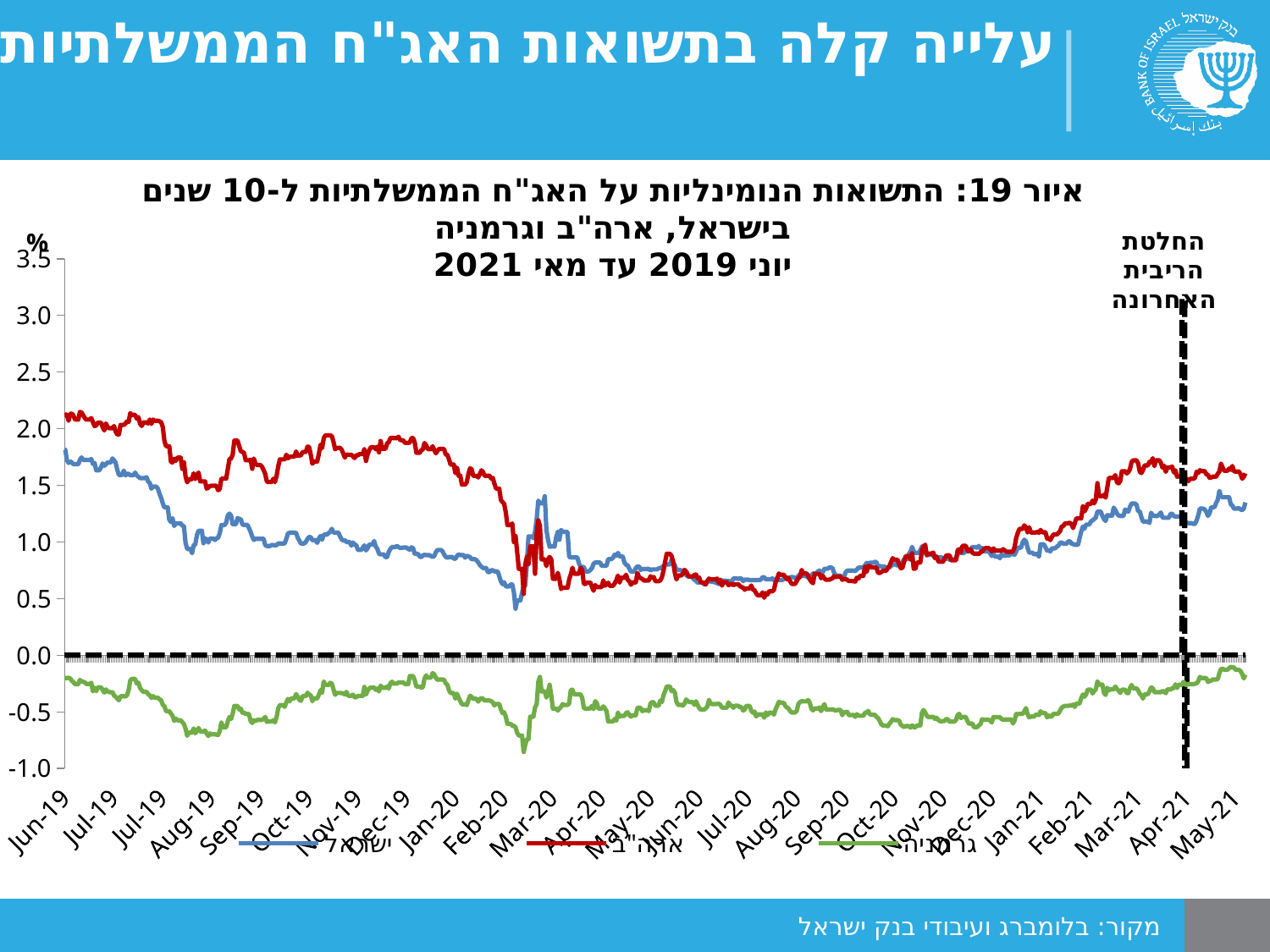
Is the value for ישראל at Jun-19 greater or less than 1.5? greater Does the ארה"ב series rise or fall between Jun-19 and Jul-20? fall At May-21, which is higher, ישראל or גרמניה? ישראל Which series has the lowest values throughout the whole period? גרמניה Is the lowest value of the גרמניה series (around Mar-20) greater or less than -0.5? less Which series has the highest value at Jun-19? ארה"ב Does the ארה"ב series rise or fall between Aug-20 and Mar-21? rise How many series does the legend list? 3 Is the value for גרמניה at Jun-19 greater or less than 0.0? less What kind of chart is shown on the slide? line chart What does the vertical dashed line near Apr-21 mark, according to the label on the chart? החלטת הריבית האחרונה